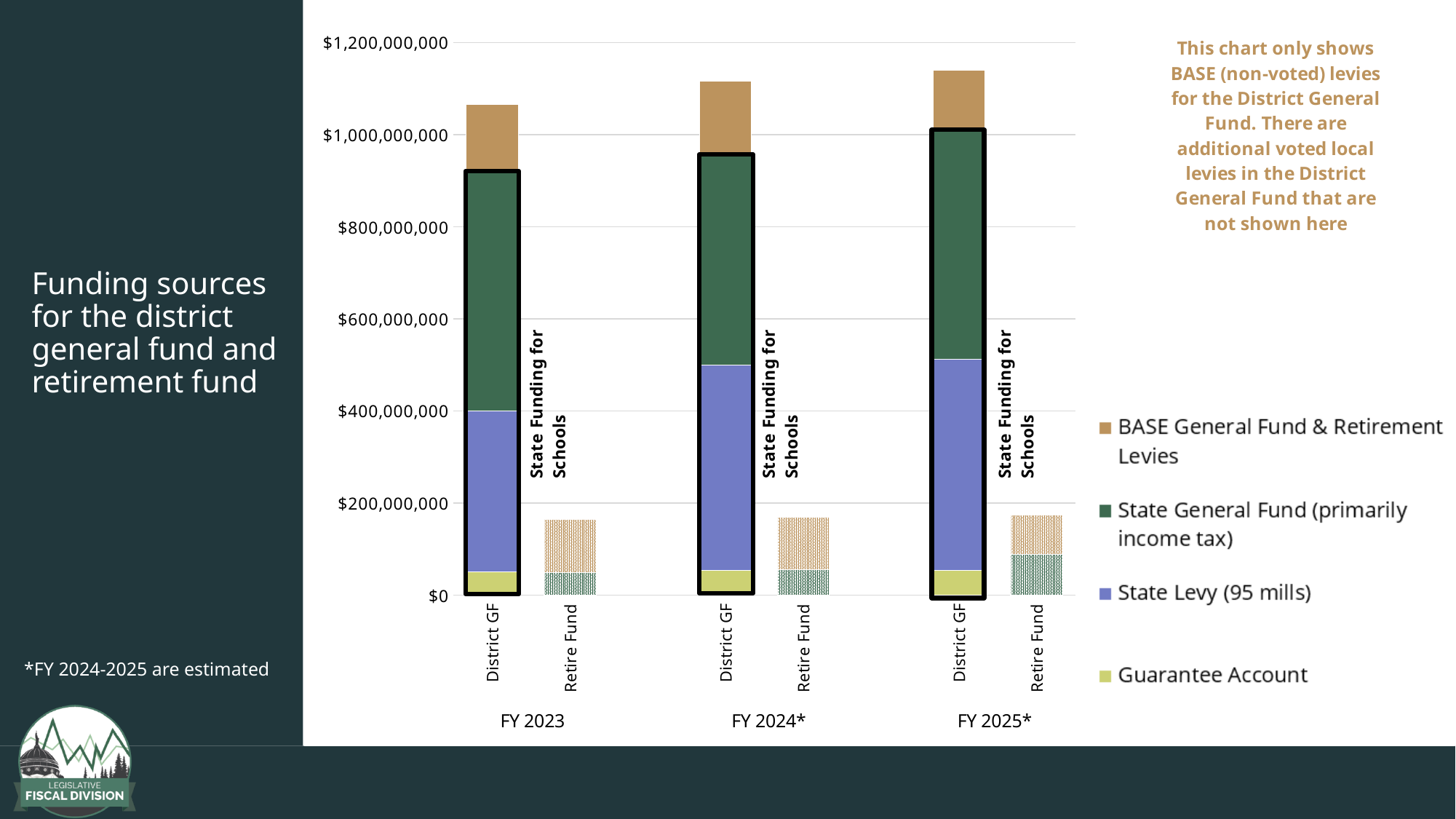
Is the total of the Retire Fund bar for FY 2023 greater or less than $200,000,000? less Which legend entry is shown in purple? State Levy (95 mills) Is the total of the District GF bar for FY 2025* greater or less than $1,000,000,000? greater How many bars are plotted in the chart? 6 Is the total of the District GF bar for FY 2023 greater or less than $1,000,000,000? greater Which fiscal year has the tallest District GF bar? FY 2025* What kind of chart is shown on the slide? stacked bar chart Do the District GF bar totals rise or fall from FY 2023 to FY 2025*? rise Which is larger, the District GF bar for FY 2025* or the District GF bar for FY 2023? District GF for FY 2025* How many fiscal years are shown on the x axis? 3 Which fiscal year has the shortest District GF bar? FY 2023 How many series does the legend list? 4